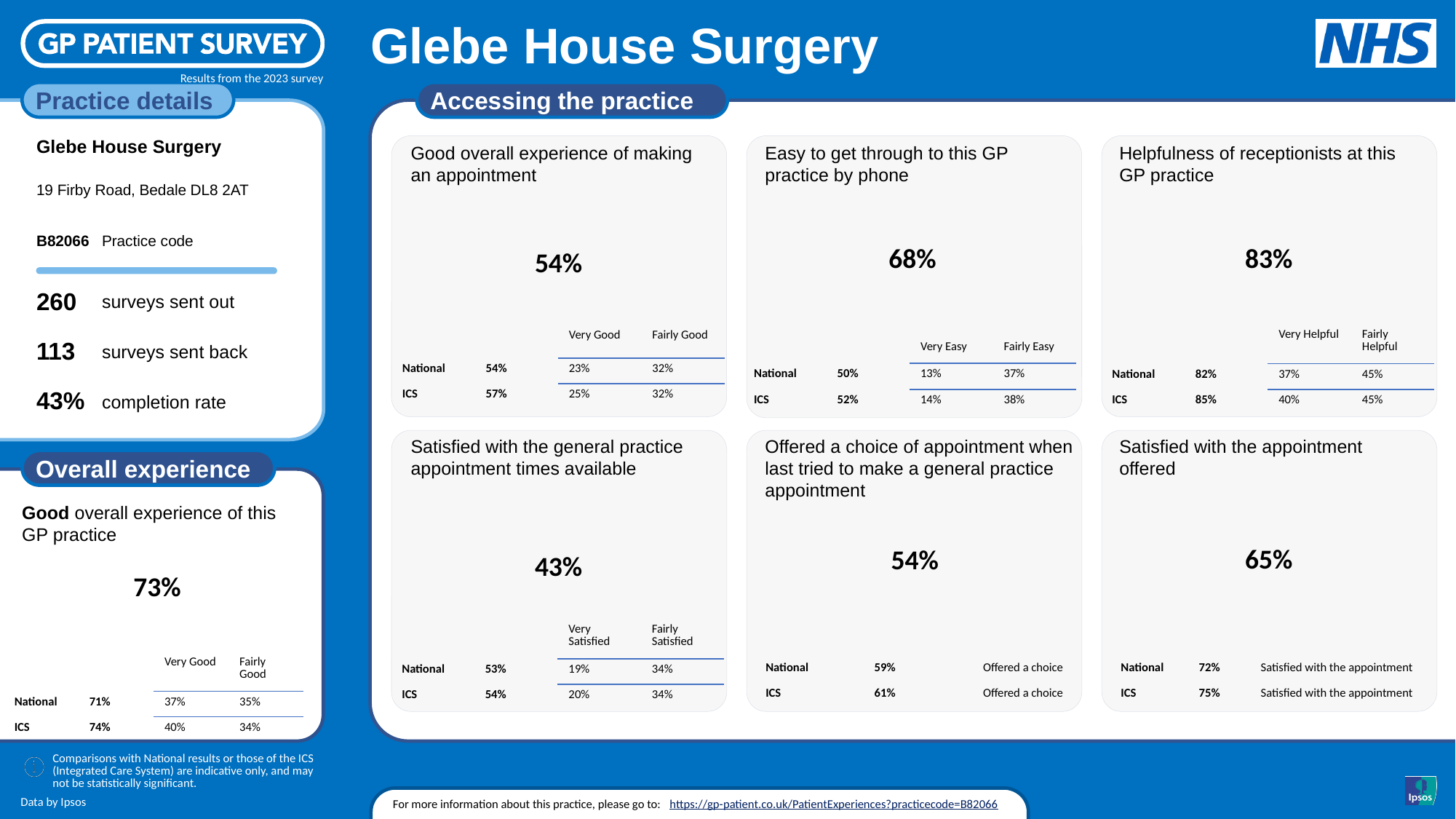
Which of the six 'Accessing the practice' panels shows the lowest headline percentage? Satisfied with the general practice appointment times available In the 'Helpfulness of receptionists at this GP practice' panel, what is the ICS value? 85% In the 'Satisfied with the general practice appointment times available' panel, what is the National value? 53% In the 'Satisfied with the appointment offered' panel, what is the practice's headline percentage? 65% In the 'Good overall experience of making an appointment' panel, what is the practice's headline percentage? 54% In the 'Offered a choice of appointment when last tried to make a general practice appointment' panel, what is the ICS value? 61% In the 'Easy to get through to this GP practice by phone' panel, what is the ICS 'Fairly Easy' percentage? 38% In the 'Good overall experience of this GP practice' panel, what is the National 'Very Good' percentage? 37% In the 'Satisfied with the appointment offered' panel, which is larger, the National value or the ICS value? ICS In the 'Helpfulness of receptionists at this GP practice' panel, what is the difference between the practice's headline value and the National value? 1% In the 'Easy to get through to this GP practice by phone' panel, what is the practice's headline percentage? 68% Which of the six 'Accessing the practice' panels shows the highest headline percentage? Helpfulness of receptionists at this GP practice